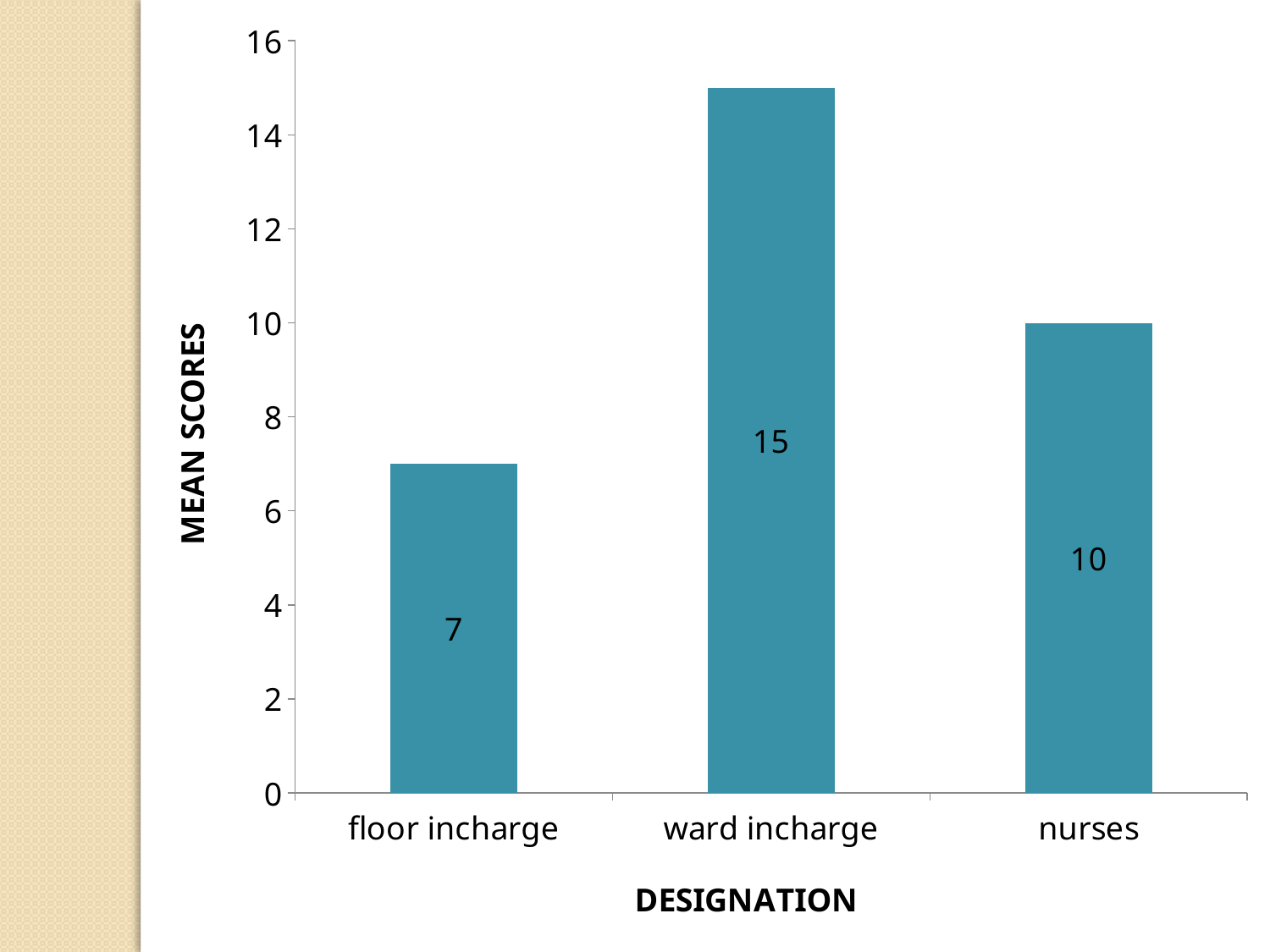
Is the mean score for ward incharge greater or less than 12? greater How many designations are shown on the x axis? 3 What is the mean score for ward incharge? 15 What kind of chart is shown on the slide? bar chart What is the mean score for nurses? 10 What is the difference between the mean scores of ward incharge and floor incharge? 8 What is the mean score for floor incharge? 7 Which designation has the highest mean score? ward incharge Which designation has the lowest mean score? floor incharge What is the difference between the mean scores of nurses and floor incharge? 3 What is the label of the vertical axis? MEAN SCORES Which has a higher mean score, nurses or floor incharge? nurses